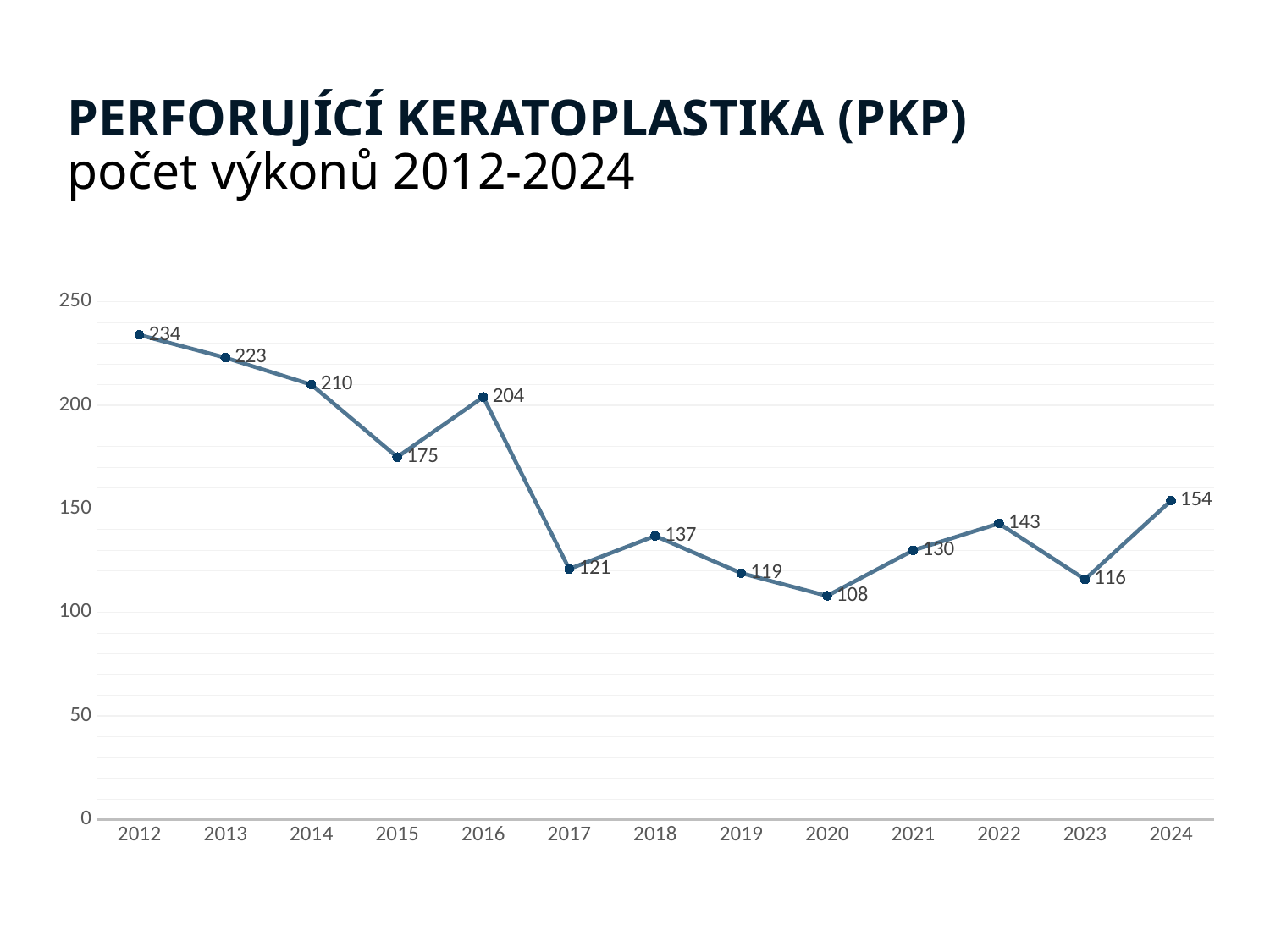
Which year has the lowest value? 2020 What is the value for 2012? 234 Is the value for 2015 greater or less than 200? less What is the difference between the values for 2016 and 2017? 83 What is the value for 2020? 108 What is the title of the chart? PERFORUJÍCÍ KERATOPLASTIKA (PKP) počet výkonů 2012-2024 What is the value for 2024? 154 Which is larger, the value for 2018 or the value for 2022? 2022 What kind of chart is shown on the slide? line chart Do the values generally rise or fall from 2012 to 2020? fall How many years are plotted on the chart? 13 Which year has the highest value? 2012